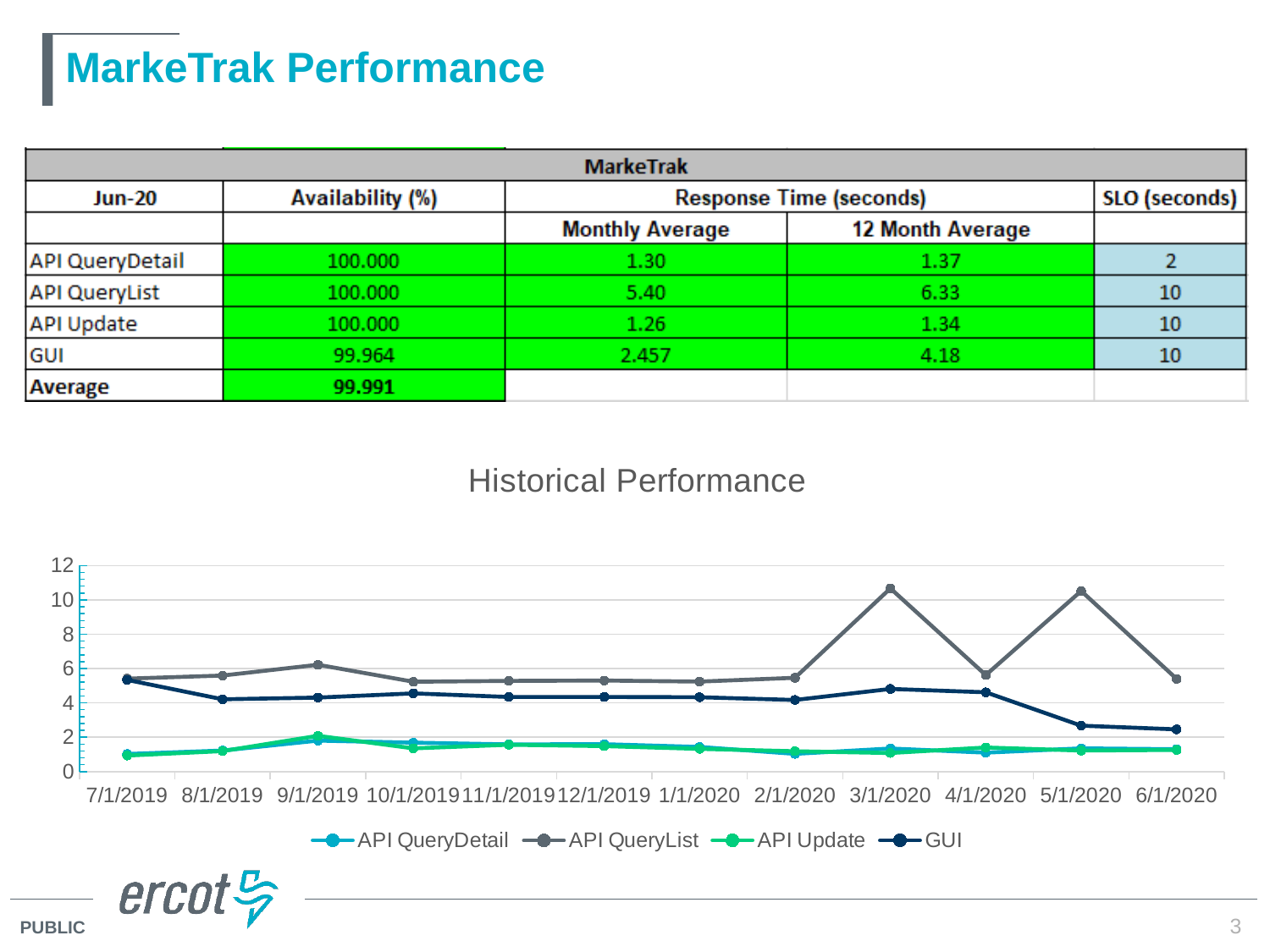
How many dates are plotted along the x axis of the Historical Performance chart? 12 How many series does the legend of the Historical Performance chart list? 4 In the Historical Performance chart, is the value for GUI at 6/1/2020 greater or less than 4? less In the Historical Performance chart, which is larger: the GUI value at 7/1/2019 or the GUI value at 6/1/2020? 7/1/2019 In the Historical Performance chart, which series has the highest value at 3/1/2020? API QueryList In the Historical Performance chart, does the GUI series rise or fall from 4/1/2020 to 6/1/2020? fall In the Historical Performance chart, which is larger at 8/1/2019: API QueryList or GUI? API QueryList In the Historical Performance chart, is the value for API Update at 7/1/2019 greater or less than 2? less What kind of chart is shown under the heading Historical Performance? line chart In the Historical Performance chart, is the value for API QueryList at 3/1/2020 greater or less than 8? greater What is the title of the line chart on the slide? Historical Performance